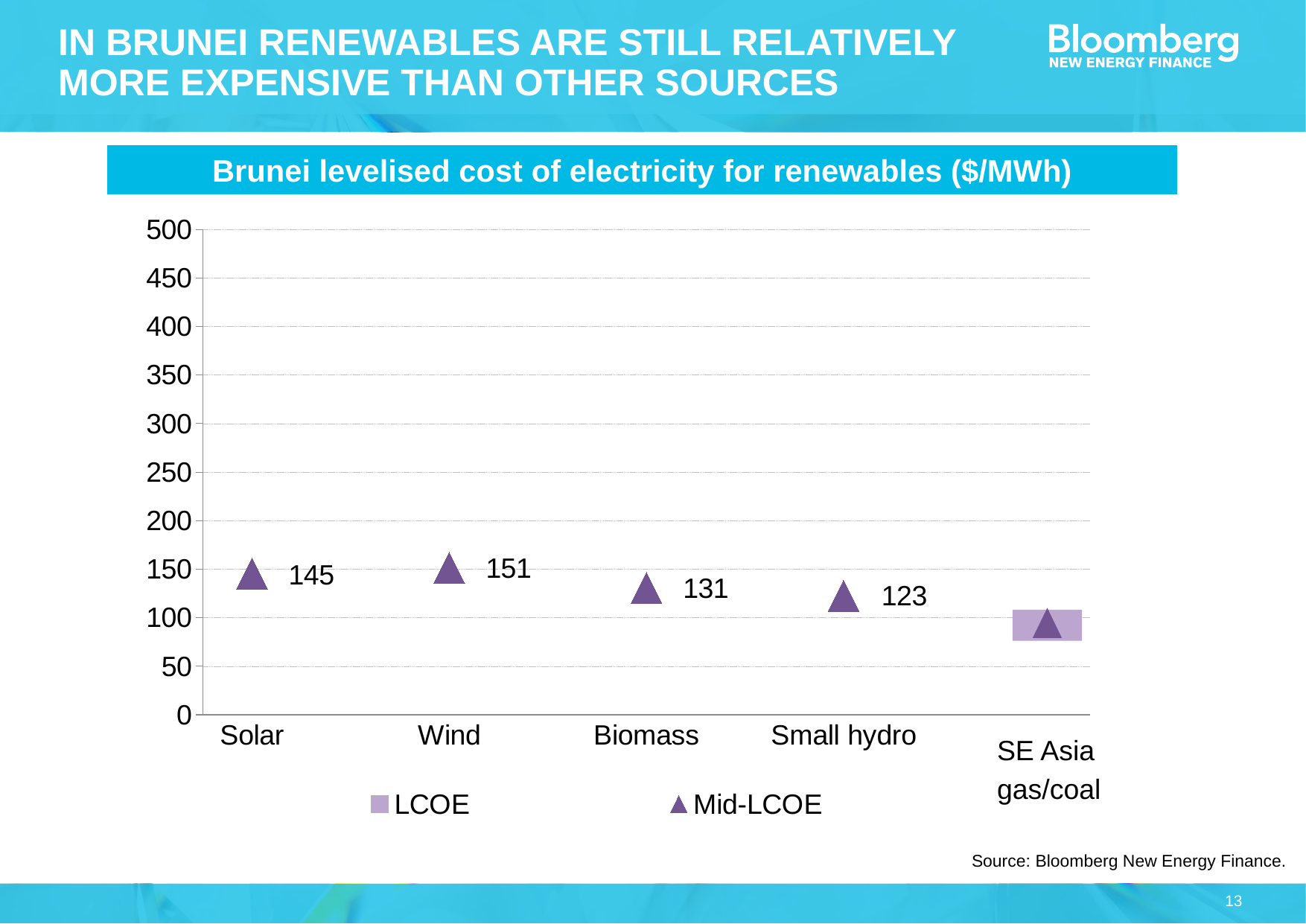
Which has a higher Mid-LCOE value, Solar or Biomass? Solar What is the difference between the Mid-LCOE values for Wind and Solar? 6 What is the difference between the Mid-LCOE values for Biomass and Small hydro? 8 What is the Mid-LCOE value for Wind? 151 How many categories are shown on the x axis? 5 Which category has the lowest Mid-LCOE value? SE Asia gas/coal What is the Mid-LCOE value for Small hydro? 123 What is the Mid-LCOE value for Solar? 145 Is the Mid-LCOE value for SE Asia gas/coal greater or less than 150? less How many series does the legend list? 2 Which category has the highest Mid-LCOE value? Wind What is the Mid-LCOE value for Biomass? 131